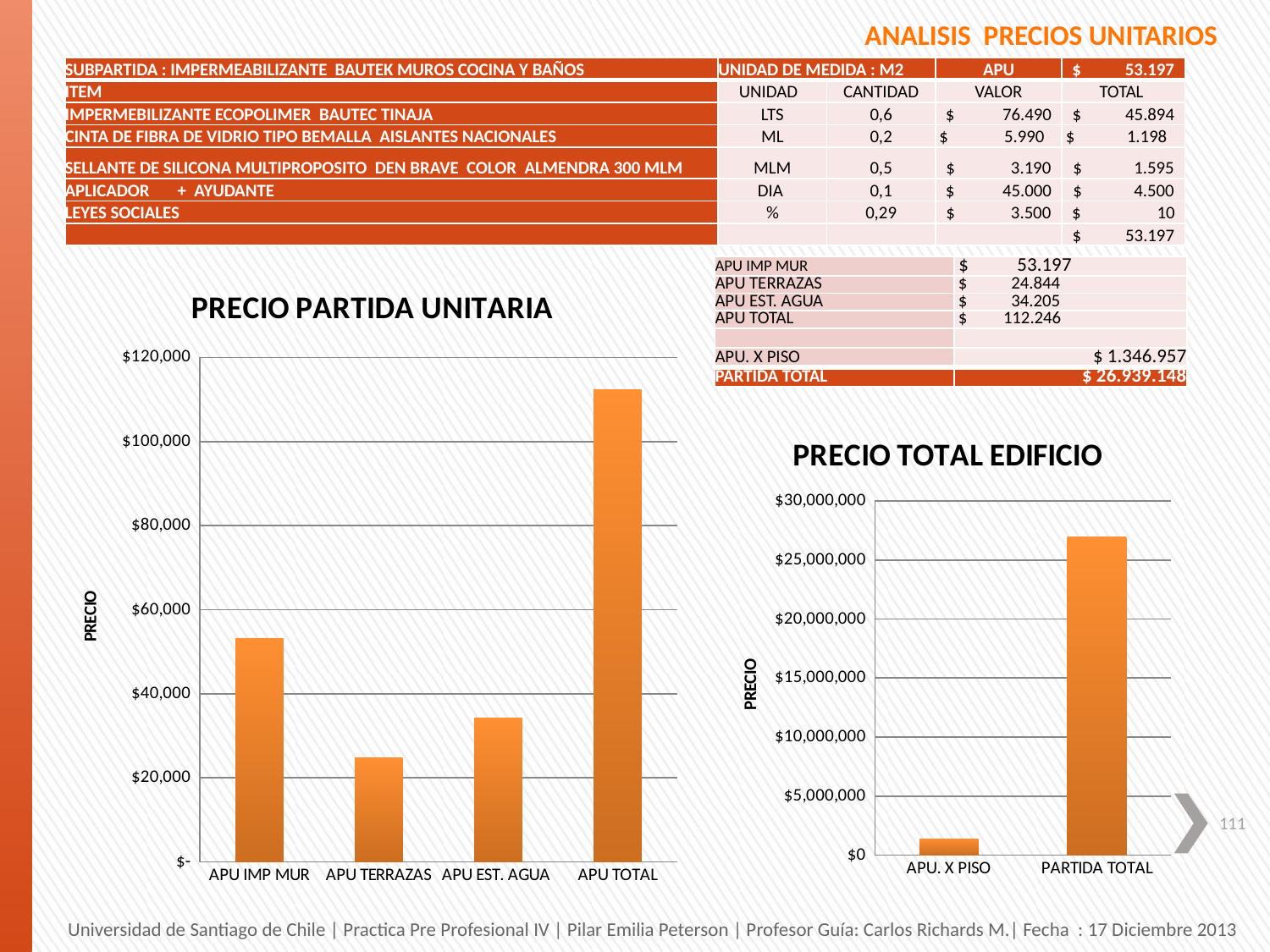
What kind of chart is PRECIO TOTAL EDIFICIO? bar chart In the PRECIO TOTAL EDIFICIO chart, which category has the highest value? PARTIDA TOTAL In the PRECIO PARTIDA UNITARIA chart, is the value for APU TERRAZAS greater or less than $20,000? greater In the PRECIO PARTIDA UNITARIA chart, is the value for APU TOTAL greater or less than $100,000? greater In the PRECIO PARTIDA UNITARIA chart, is the value for APU IMP MUR greater or less than $60,000? less In the PRECIO PARTIDA UNITARIA chart, which is larger, APU IMP MUR or APU EST. AGUA? APU IMP MUR How many categories are shown in the PRECIO PARTIDA UNITARIA chart? 4 In the PRECIO PARTIDA UNITARIA chart, which category has the lowest value? APU TERRAZAS What is the y-axis title of the PRECIO TOTAL EDIFICIO chart? PRECIO In the PRECIO PARTIDA UNITARIA chart, which category has the highest value? APU TOTAL